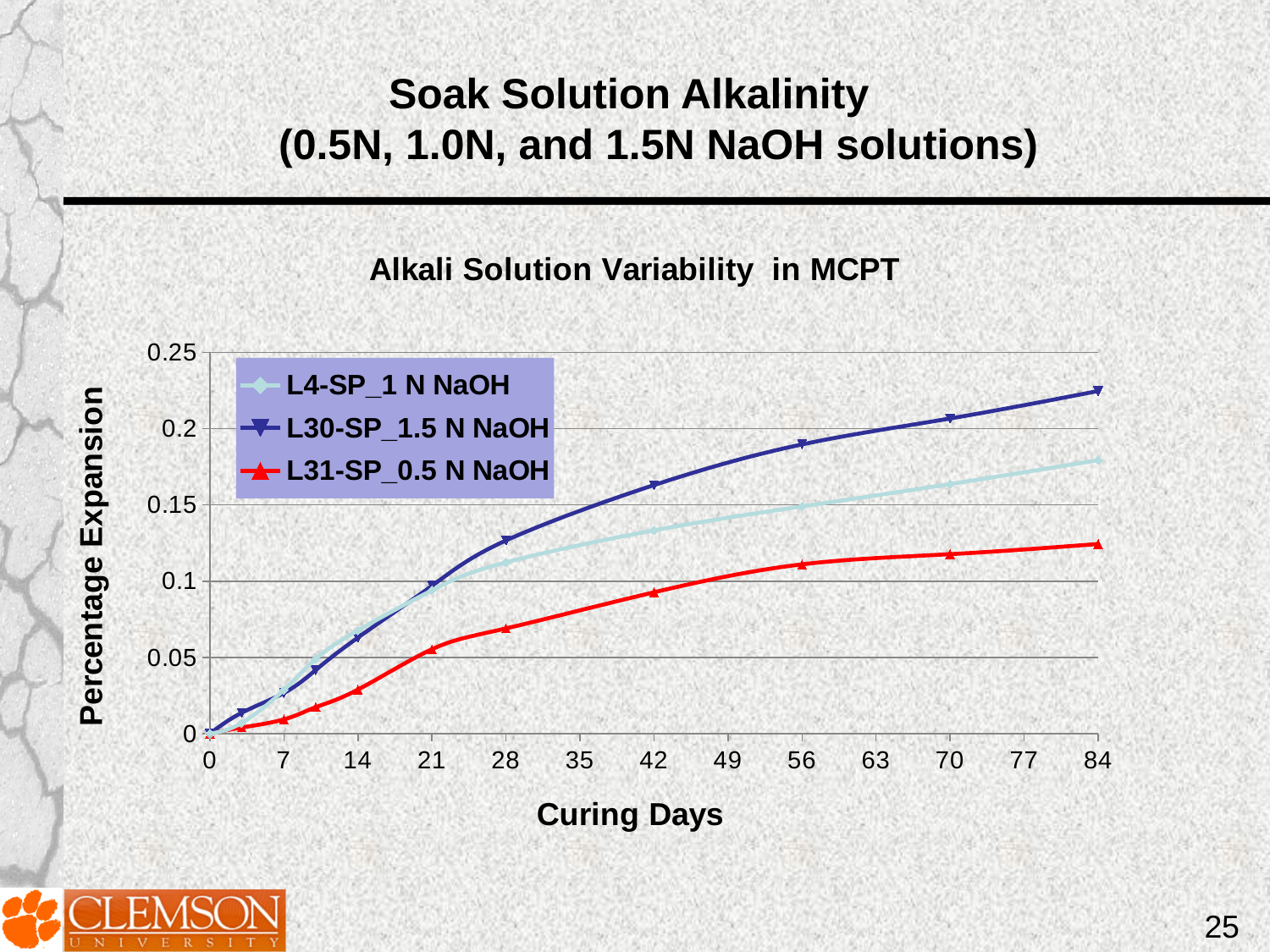
Is the value for L30-SP_1.5 N NaOH at 84 curing days greater or less than 0.2? greater Which series has the highest value at 84 curing days? L30-SP_1.5 N NaOH What kind of chart is shown on the slide? line chart Do the values for L30-SP_1.5 N NaOH rise or fall as curing days increase? rise How many series does the legend list? 3 At 42 curing days, which is larger: L4-SP_1 N NaOH or L31-SP_0.5 N NaOH? L4-SP_1 N NaOH What is the title of the chart? Alkali Solution Variability in MCPT Which series has the lowest value at 84 curing days? L31-SP_0.5 N NaOH What is the label of the y axis? Percentage Expansion Is the value for L4-SP_1 N NaOH at 84 curing days greater or less than 0.15? greater Is the value for L31-SP_0.5 N NaOH at 84 curing days greater or less than 0.15? less